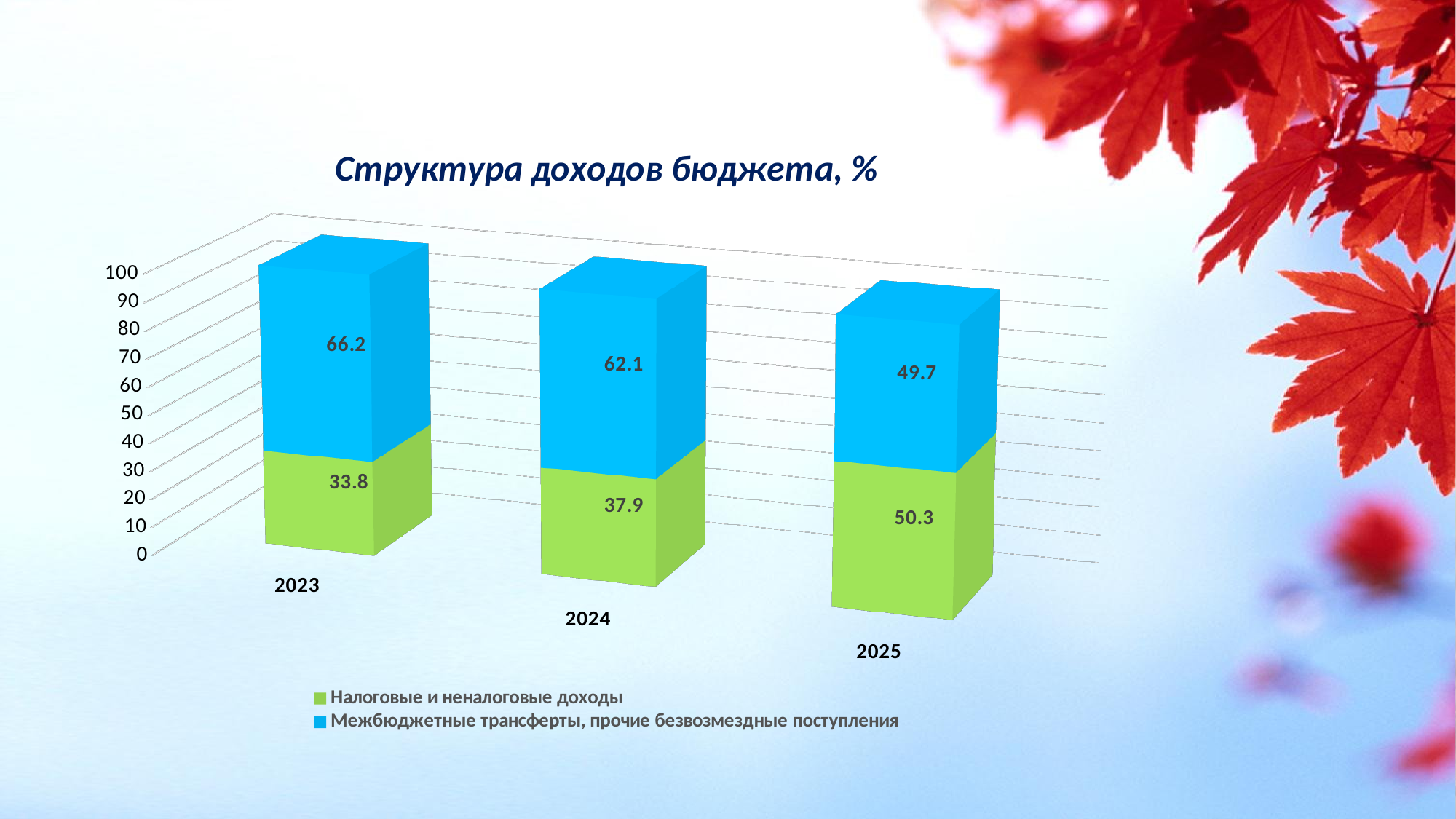
What is the value for Налоговые и неналоговые доходы in 2023? 33.8 How many series does the legend list? 2 What is the value for Межбюджетные трансферты, прочие безвозмездные поступления in 2025? 49.7 What is the difference between the Налоговые и неналоговые доходы values for 2025 and 2023? 16.5 How many years are shown on the x axis? 3 What kind of chart is shown on the slide? Stacked bar chart What is the value for Межбюджетные трансферты, прочие безвозмездные поступления in 2024? 62.1 In which year is the value for Налоговые и неналоговые доходы highest? 2025 In which year is the value for Межбюджетные трансферты, прочие безвозмездные поступления lowest? 2025 Does the value for Налоговые и неналоговые доходы rise or fall from 2023 to 2025? Rise What is the total of the stacked bar for 2024? 100 Which is larger in 2024: Налоговые и неналоговые доходы or Межбюджетные трансферты, прочие безвозмездные поступления? Межбюджетные трансферты, прочие безвозмездные поступления